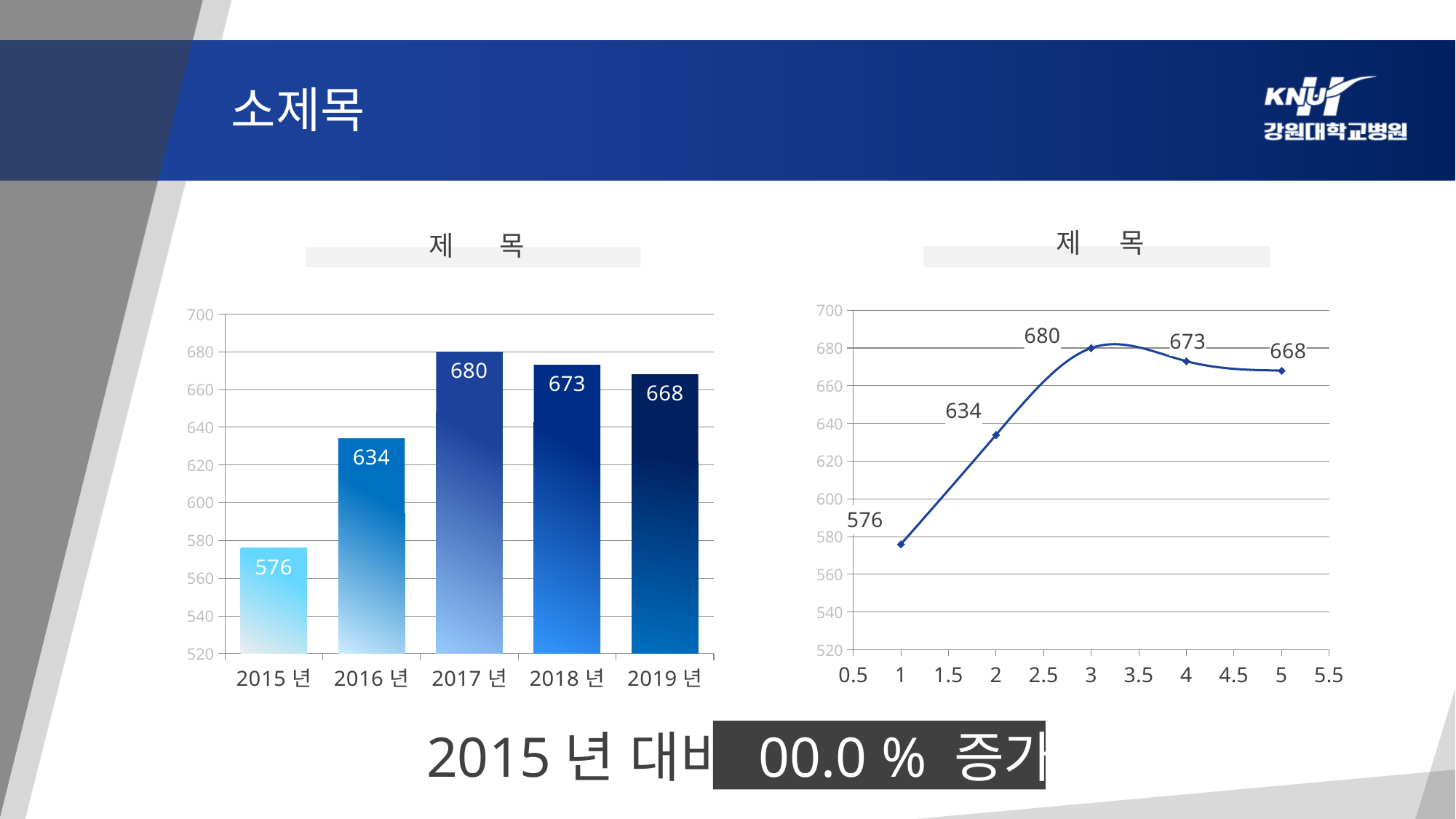
In the bar chart on the left, which year has the highest value? 2017 년 How many bars are in the bar chart on the left? 5 In the bar chart on the left, which is larger, the value for 2018 년 or 2019 년? 2018 년 In the line chart on the right, what is the value at x = 4? 673 In the bar chart on the left, what is the value for 2017 년? 680 What kind of chart is on the right side of the slide? line chart In the line chart on the right, what is the difference between the values at x = 3 and x = 5? 12 In the bar chart on the left, what is the value for 2015 년? 576 What kind of chart is on the left side of the slide? bar chart In the line chart on the right, do the values rise or fall from x = 1 to x = 3? rise In the bar chart on the left, which year has the lowest value? 2015 년 In the bar chart on the left, what is the difference between the values for 2016 년 and 2015 년? 58